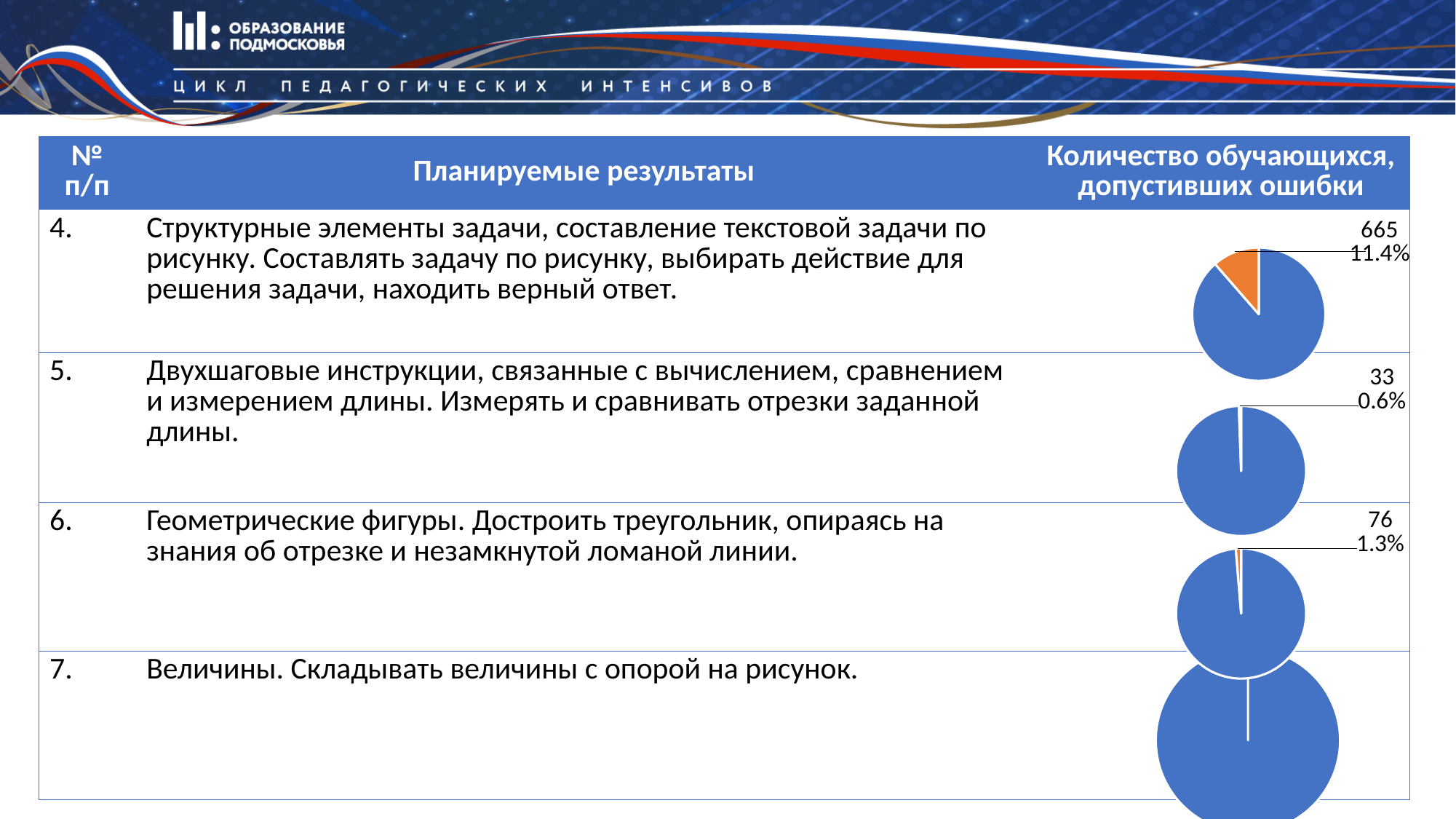
What kind of chart is shown in row 4 of the table? pie chart Which is larger: the number of students who made errors in row 6 or in row 5? row 6 Among the pie charts with printed labels, which row shows the smallest number of students who made errors? row 5 What is the difference between the number of students who made errors in row 4 and in row 5? 632 In the pie chart for row 4, how many students made errors? 665 Which row's pie chart shows the largest share of students who made errors? row 4 In the pie chart for row 5, how many students made errors? 33 In the pie chart for row 5, what share of students made errors? 0.6% In the pie chart for row 4, what share of students made errors? 11.4% How many pie charts are shown on the slide? 4 In the pie chart for row 6, what share of students made errors? 1.3% In the pie chart for row 6, how many students made errors? 76